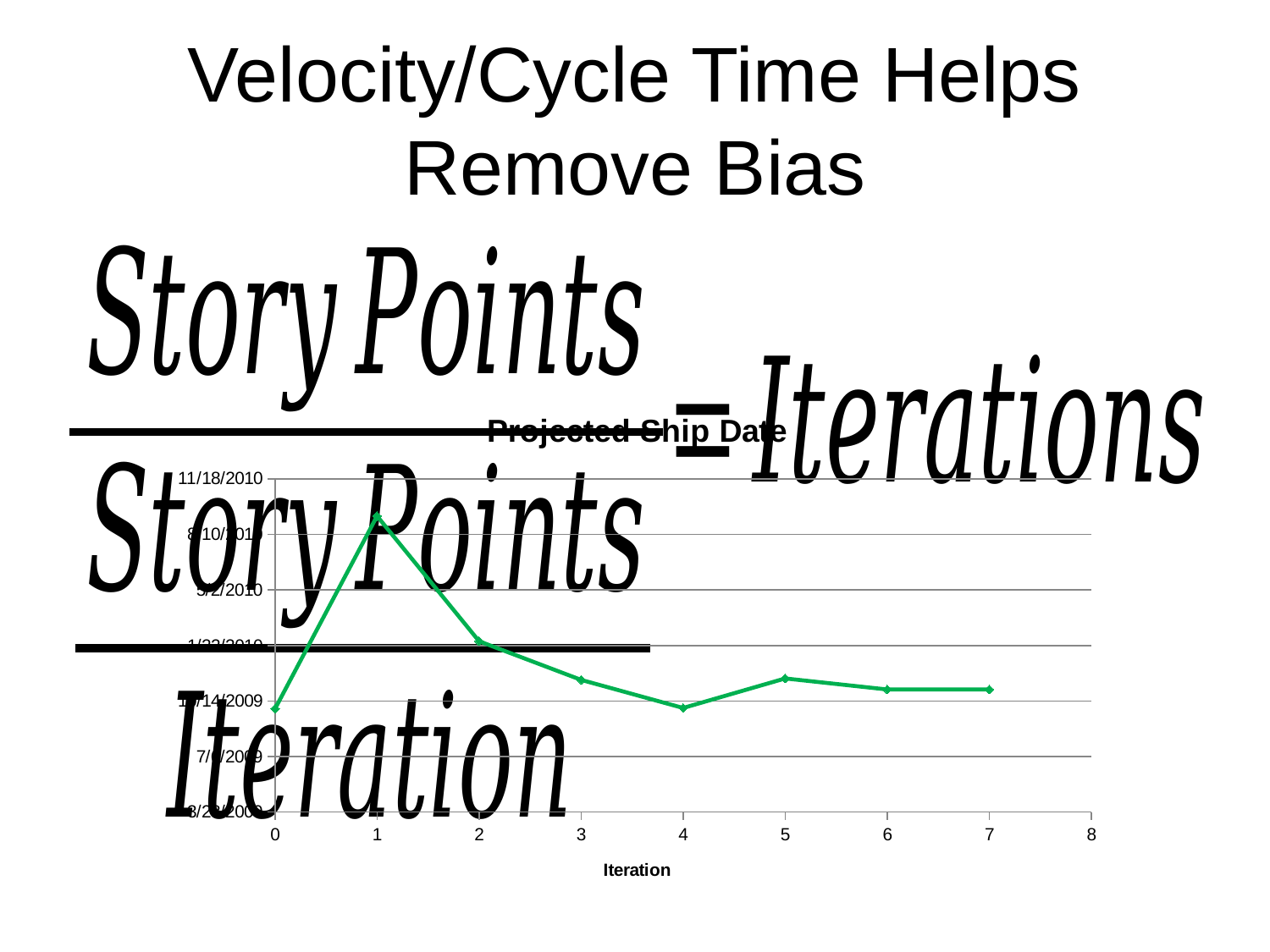
Does the Projected Ship Date line rise or fall between iteration 0 and iteration 1? rise In the Projected Ship Date chart, which is higher: the value at iteration 4 or at iteration 5? iteration 5 Does the Projected Ship Date line rise or fall between iteration 1 and iteration 4? fall What kind of chart is shown under the title "Projected Ship Date"? line chart In the Projected Ship Date chart, is the value at iteration 3 earlier or later than 1/22/2010? earlier What is the title of the chart on the slide? Projected Ship Date At which iteration does the Projected Ship Date line reach its highest point? 1 How many data points are plotted on the Projected Ship Date line? 8 In the Projected Ship Date chart, which is higher: the value at iteration 1 or at iteration 2? iteration 1 In the Projected Ship Date chart, which is higher: the value at iteration 3 or at iteration 4? iteration 3 What is the x-axis title of the Projected Ship Date chart? Iteration